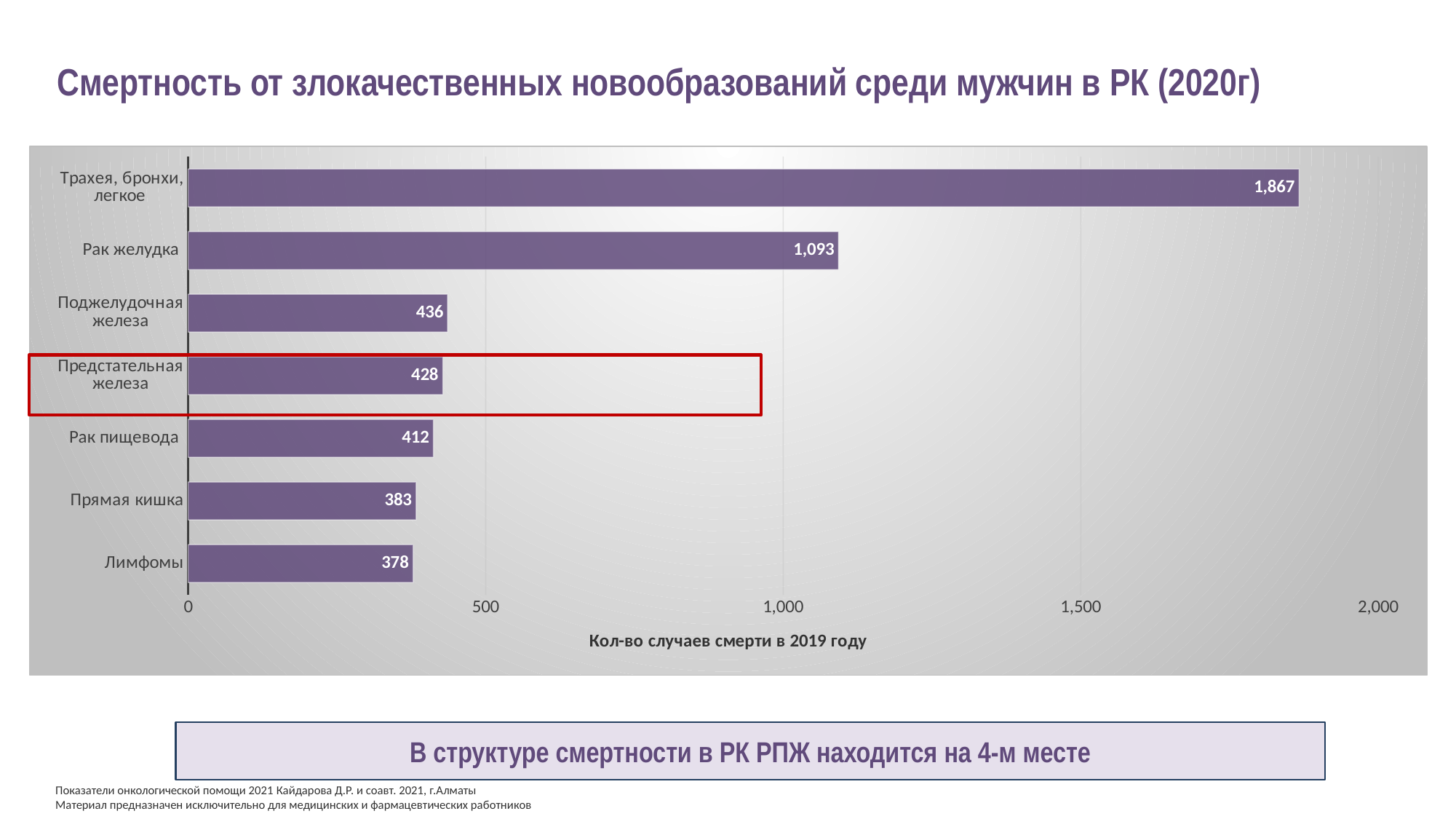
What is the difference between the values for Трахея, бронхи, легкое and Рак желудка? 774 Which is larger, the value for Рак пищевода or the value for Прямая кишка? Рак пищевода What is the label of the horizontal axis? Кол-во случаев смерти в 2019 году What is the value for Предстательная железа? 428 What is the difference between the values for Поджелудочная железа and Предстательная железа? 8 Which category has the lowest value? Лимфомы What is the value for Трахея, бронхи, легкое? 1,867 How many categories are shown in the chart? 7 What is the value for Рак желудка? 1,093 What is the value for Лимфомы? 378 What kind of chart is shown on the slide? Bar chart Which category has the highest value? Трахея, бронхи, легкое